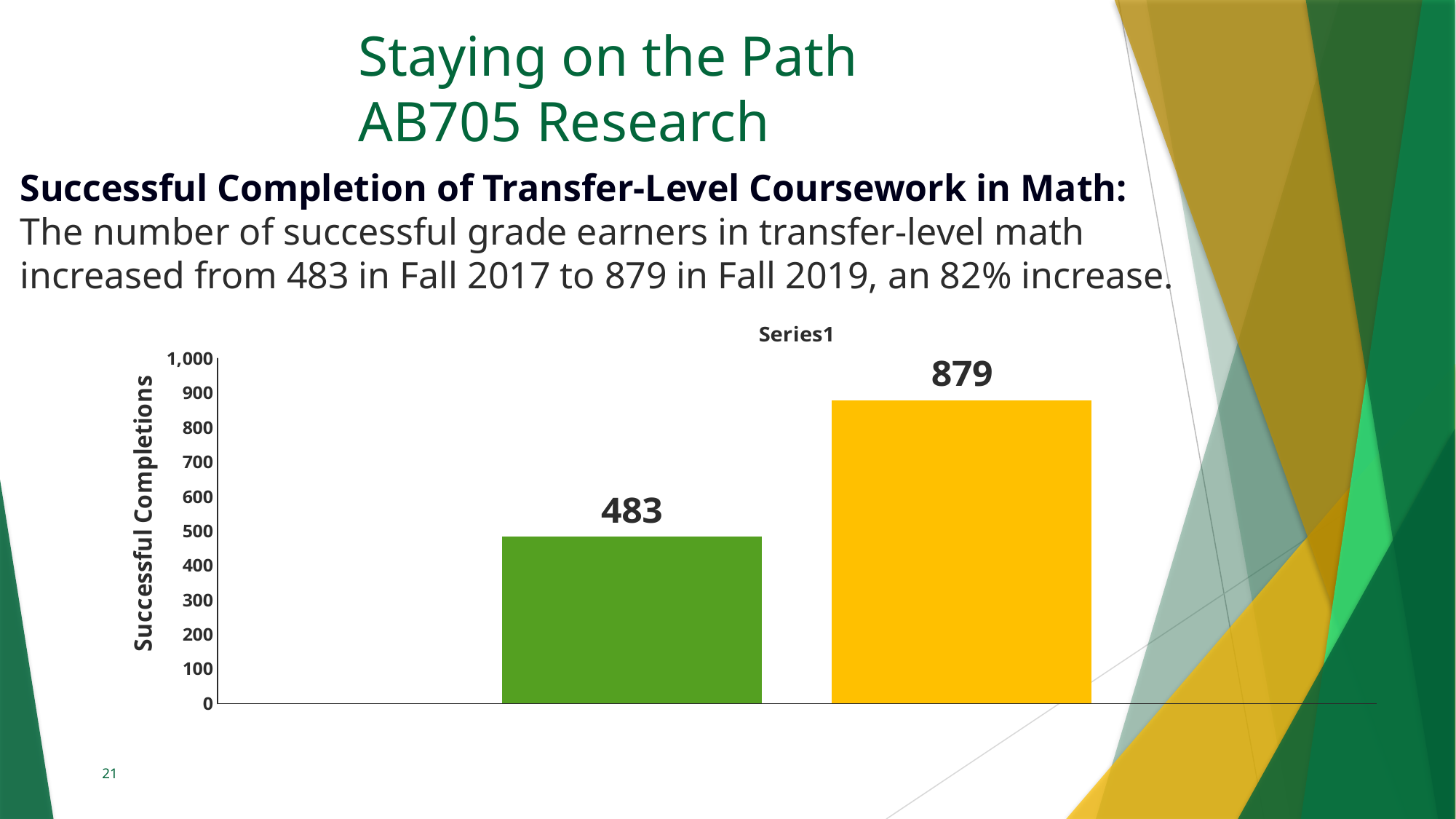
What is the highest tick value shown on the vertical axis? 1,000 Is the value of the green bar greater or less than 500? less How many bars are plotted in the chart? 2 What kind of chart is shown on the slide? bar chart What is the title of the vertical axis? Successful Completions What is the value shown on the green bar? 483 What is the value shown on the yellow bar? 879 According to the slide, what was the number of successful completions in Fall 2017? 483 Is the value of the yellow bar greater or less than 800? greater Which bar has the higher value, the green bar or the yellow bar? the yellow bar What is the difference between the two bar values? 396 According to the slide, what was the number of successful completions in Fall 2019? 879